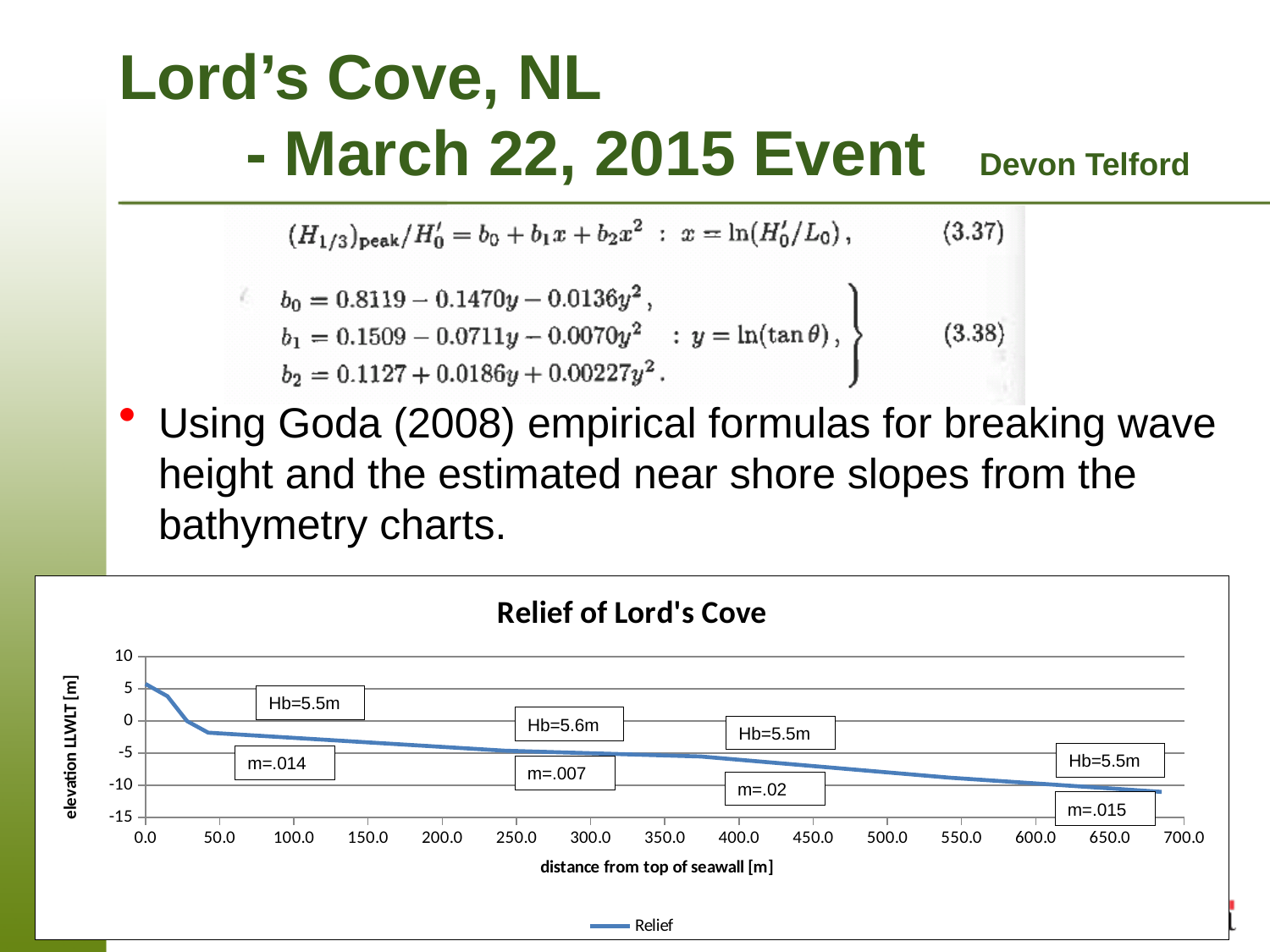
In the 'Relief of Lord's Cove' chart, is the elevation at a distance of 100.0 m greater or less than -5? greater How many series does the legend of the 'Relief of Lord's Cove' chart list? 1 In the 'Relief of Lord's Cove' chart, does the elevation generally rise or fall as distance from the top of the seawall increases? fall In the 'Relief of Lord's Cove' chart, what slope value m is annotated in the box nearest the 100.0 m mark? m=.014 In the 'Relief of Lord's Cove' chart, is the elevation at a distance of 100.0 m greater or less than 0? less In the 'Relief of Lord's Cove' chart, is the elevation at a distance of 500.0 m greater or less than -5? less What kind of chart is 'Relief of Lord's Cove'? line chart In the 'Relief of Lord's Cove' chart, which has the higher elevation: the point at 200.0 m or the point at 600.0 m? 200.0 m What is the title of the chart on the slide? Relief of Lord's Cove